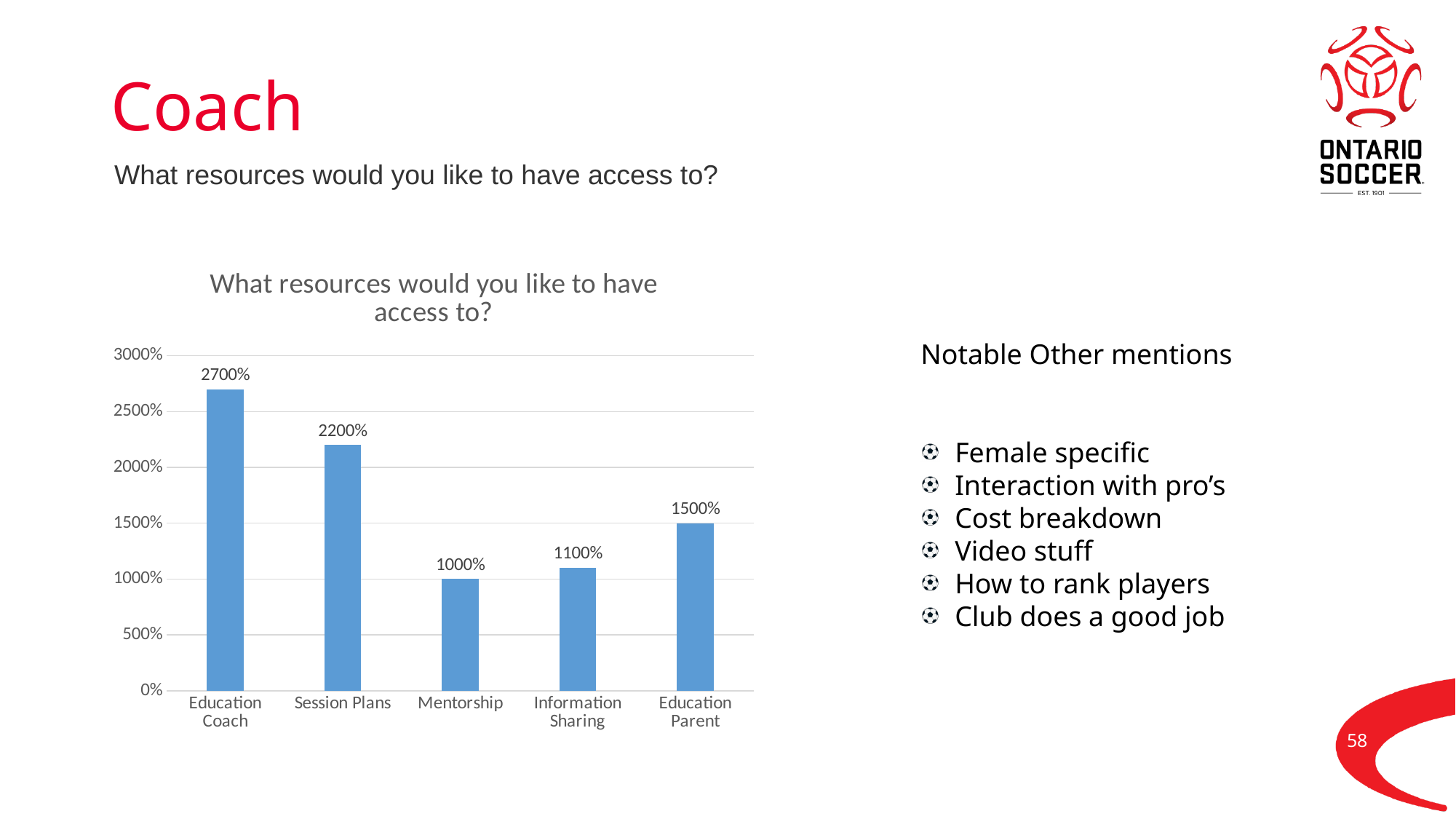
What kind of chart is shown on the slide? Bar chart What is the value for Information Sharing? 1100% What is the title of the chart? What resources would you like to have access to? What is the value for Education Parent? 1500% Which category has the lowest value? Mentorship What is the difference between the values for Education Coach and Session Plans? 500% Which is larger, the value for Education Parent or the value for Information Sharing? Education Parent Which category has the highest value? Education Coach What is the value for Mentorship? 1000% What is the value for Education Coach? 2700% How many categories are shown in the chart? 5 What is the value for Session Plans? 2200%